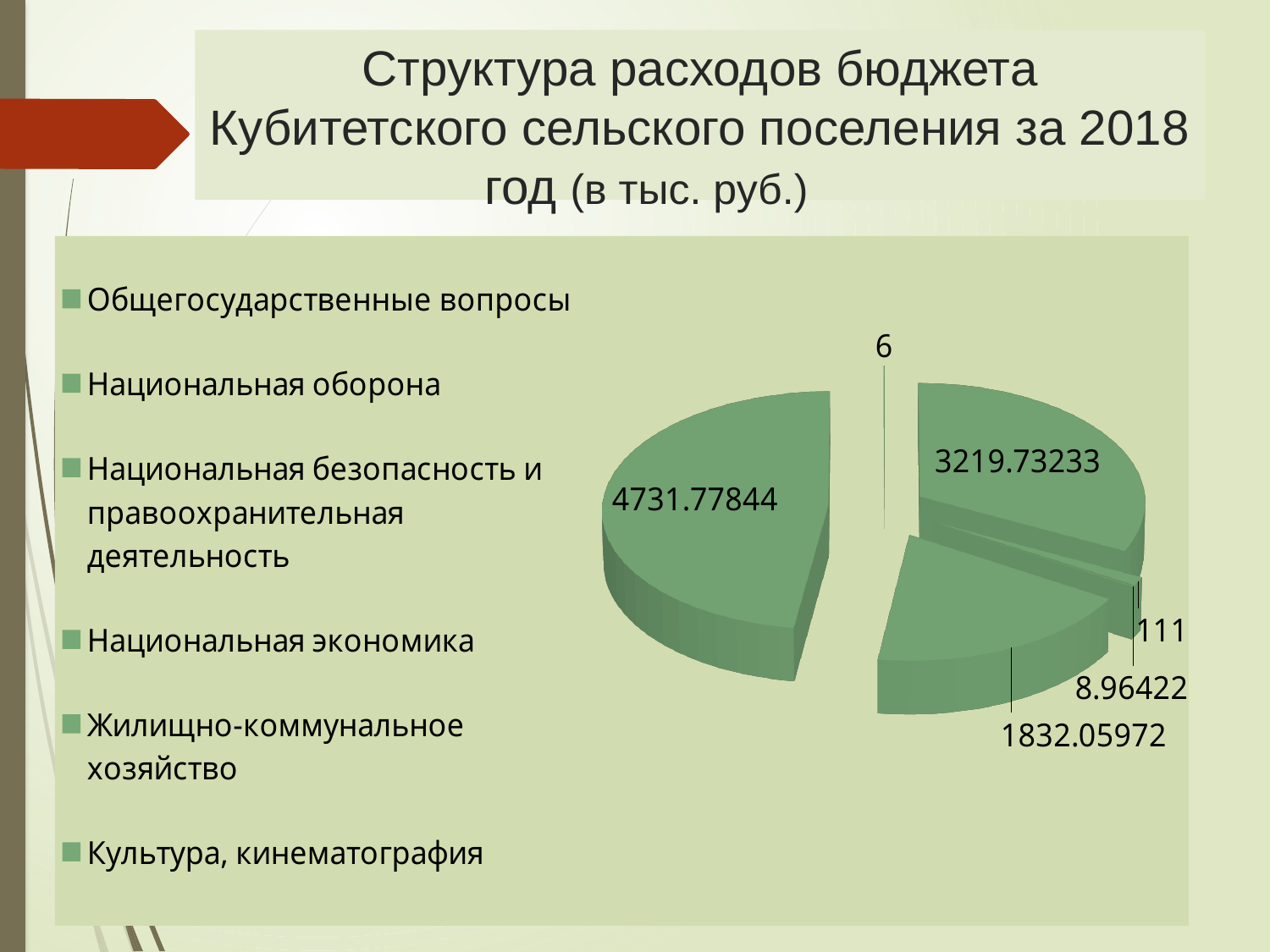
What is the difference between the largest labelled slice (4731.77844) and the second largest (3219.73233)? 1512.04611 Which is larger: the slice labelled 3219.73233 or the slice labelled 1832.05972? 3219.73233 What is the largest value labelled on the pie chart? 4731.77844 What is the smallest value labelled on the pie chart? 6 What is the difference between the slice labelled 111 and the slice labelled 6? 105 Which is larger: the slice labelled 8.96422 or the slice labelled 6? 8.96422 What kind of chart is shown on the slide? Pie chart What is the total of all six values labelled on the pie chart? 9909.53471 What is the title of the slide containing the pie chart? Структура расходов бюджета Кубитетского сельского поселения за 2018 год (в тыс. руб.) What is the first entry listed in the legend of the pie chart? Общегосударственные вопросы How many data labels are printed on the pie chart? 6 How many categories does the legend of the pie chart list? 6